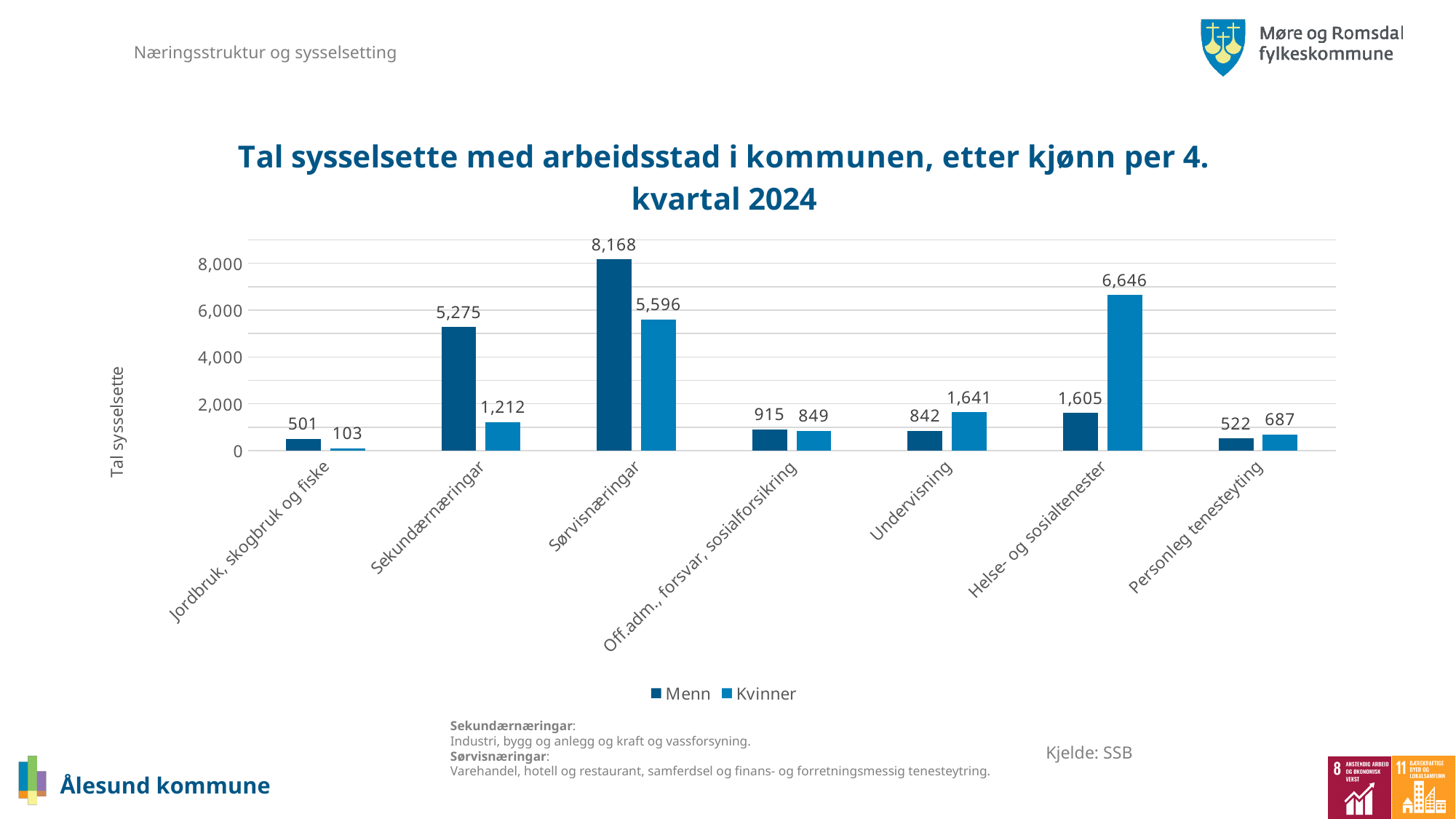
How many categories are shown on the x axis? 7 What is the value for Menn in Sørvisnæringar? 8,168 What is the value for Kvinner in Jordbruk, skogbruk og fiske? 103 Which category has the lowest value for Kvinner? Jordbruk, skogbruk og fiske How many series does the legend list? 2 What is the difference between Menn and Kvinner in Sekundærnæringar? 4,063 In Undervisning, which is larger, Menn or Kvinner? Kvinner What kind of chart is shown on the slide? Bar chart Which category has the highest value for Menn? Sørvisnæringar What is the value for Kvinner in Helse- og sosialtenester? 6,646 Is the value for Kvinner in Sørvisnæringar greater or less than 4,000? greater What is the label of the y axis? Tal sysselsette